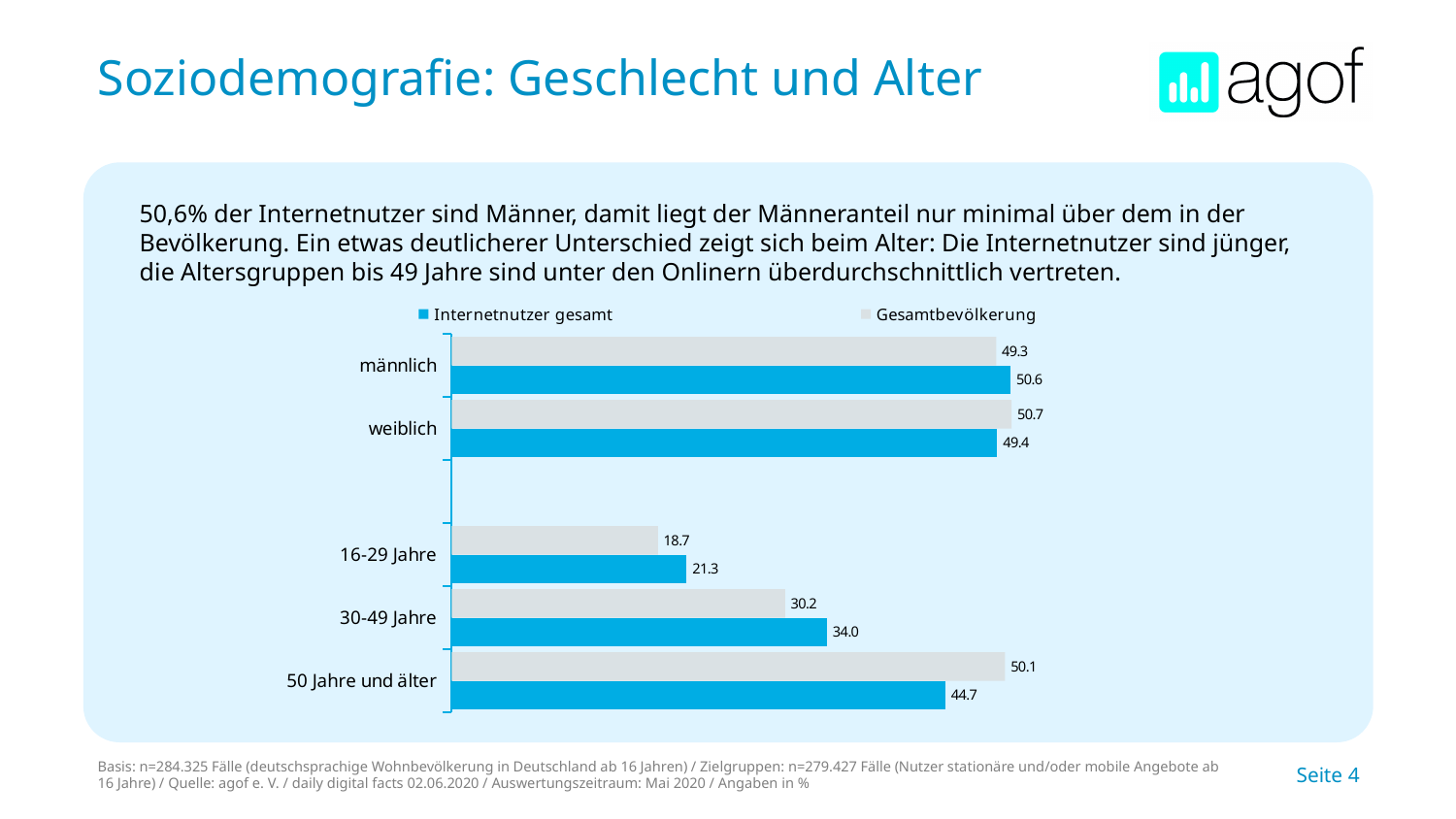
How many series does the legend list? 2 For 16-29 Jahre, which series has the larger value: Internetnutzer gesamt or Gesamtbevölkerung? Internetnutzer gesamt What is the value for Internetnutzer gesamt in the männlich category? 50.6 What kind of chart is shown on the slide? Bar chart What is the value for Gesamtbevölkerung in the 16-29 Jahre category? 18.7 How many categories are shown on the chart? 5 What is the value for Internetnutzer gesamt in the 50 Jahre und älter category? 44.7 What is the difference between the Internetnutzer gesamt and Gesamtbevölkerung values for 30-49 Jahre? 3.8 What is the value for Gesamtbevölkerung in the 30-49 Jahre category? 30.2 What is the difference between the Gesamtbevölkerung and Internetnutzer gesamt values for 50 Jahre und älter? 5.4 Among the age groups, which category has the lowest Internetnutzer gesamt value? 16-29 Jahre Among the age groups, which category has the highest Gesamtbevölkerung value? 50 Jahre und älter